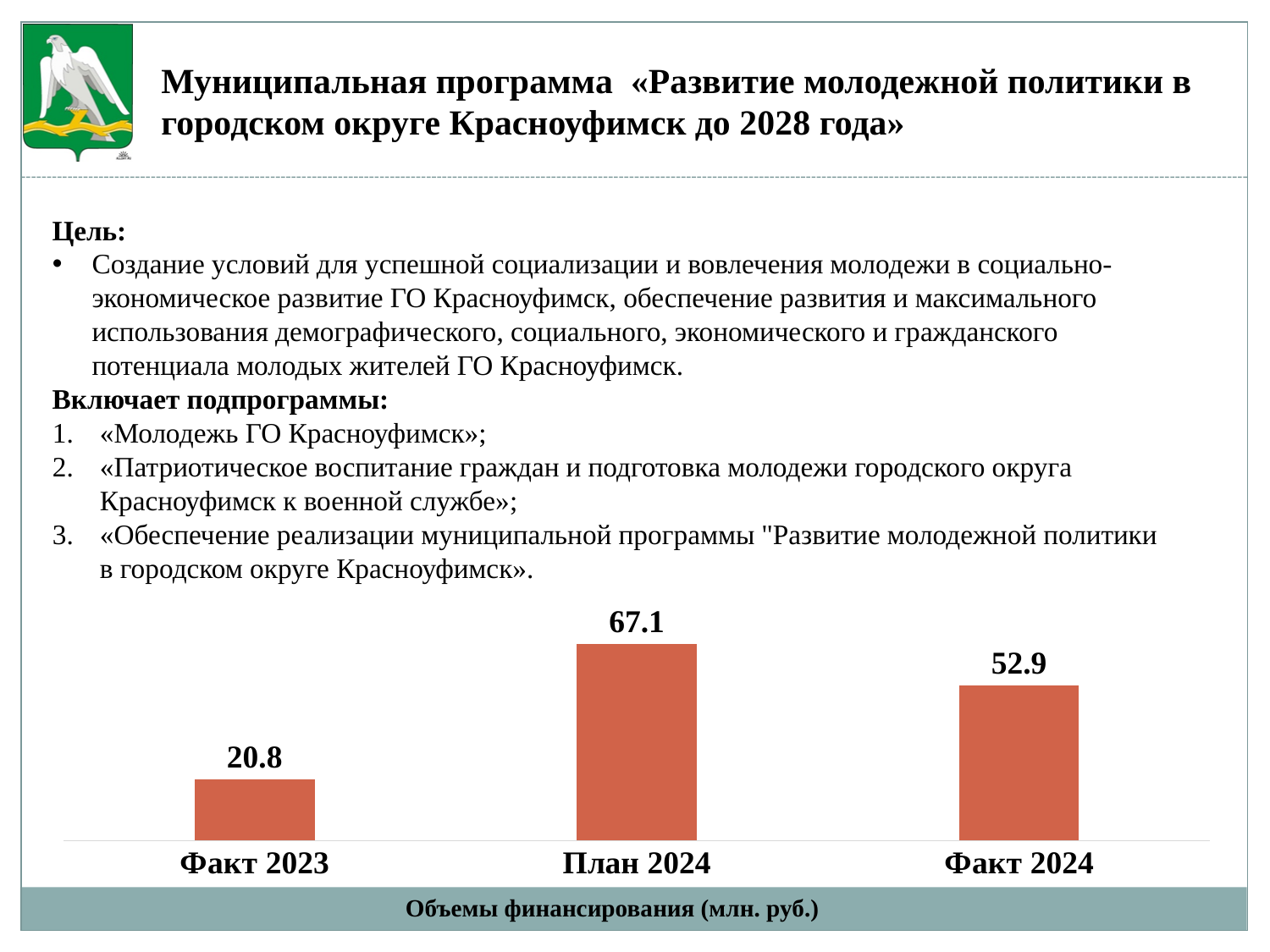
Which category has the highest value? План 2024 What is the value for Факт 2024? 52.9 What is the value for Факт 2023? 20.8 What is the difference between Факт 2024 and Факт 2023? 32.1 What is the value for План 2024? 67.1 What is the difference between План 2024 and Факт 2024? 14.2 What kind of chart is shown on the slide? Bar chart Which is larger, Факт 2023 or Факт 2024? Факт 2024 What colour are the bars in the chart? Orange-red Which category has the lowest value? Факт 2023 How many categories are shown in the chart? 3 What is the caption below the chart? Объемы финансирования (млн. руб.)